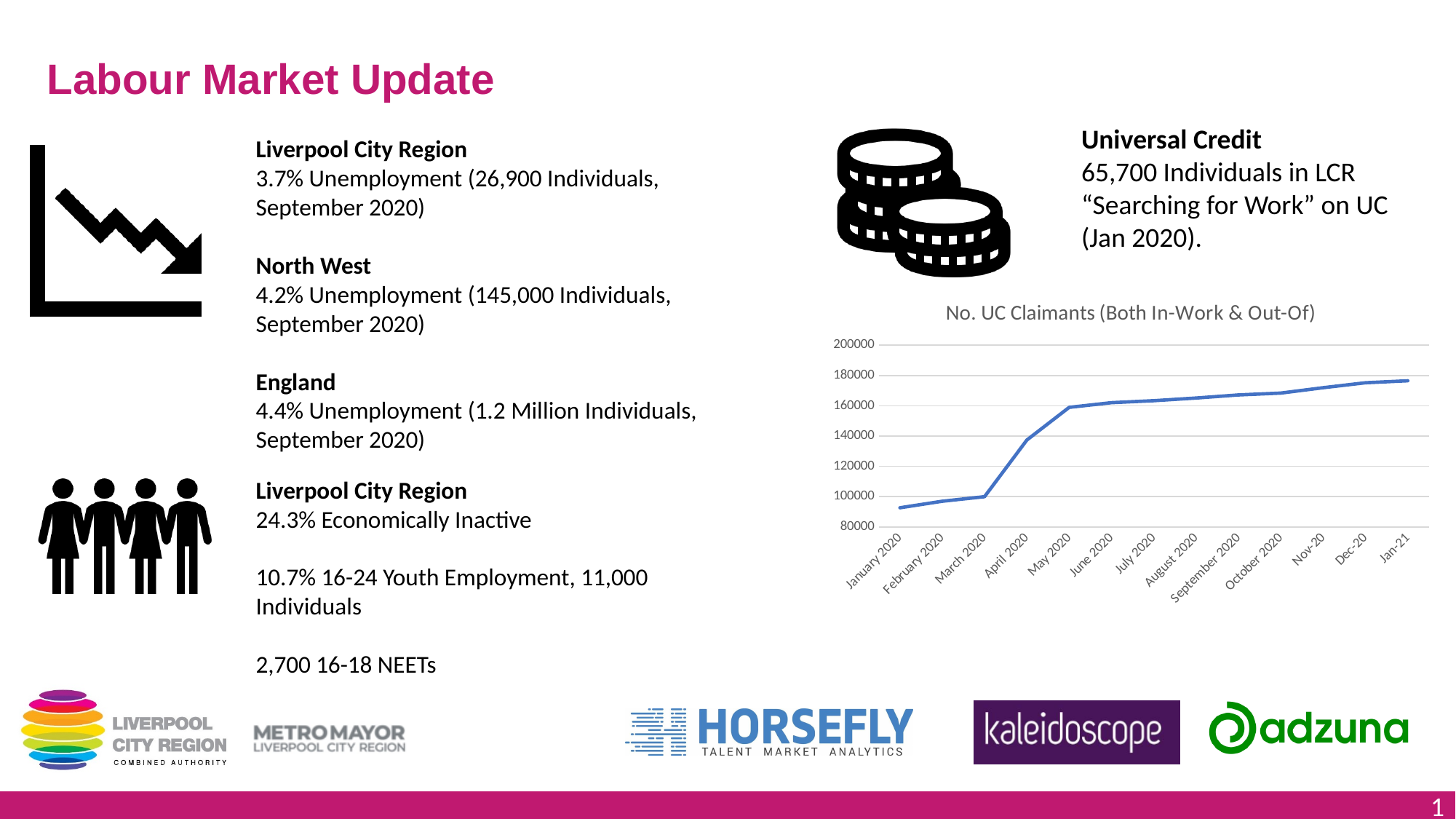
In the UC claimants chart, is the value for May 2020 greater or less than 140000? greater Which month has the highest number of UC claimants in the chart? Jan-21 Which month has the lowest number of UC claimants in the chart? January 2020 In the UC claimants chart, which is larger: the value for March 2020 or the value for May 2020? May 2020 What kind of chart is used to show the number of UC claimants? Line chart In the UC claimants chart, is the value for Jan-21 greater or less than 180000? less What is the lowest value shown on the y axis of the UC claimants chart? 80000 In the UC claimants chart, is the value for January 2020 greater or less than 100000? less How many months are plotted on the x axis of the UC claimants chart? 13 Do the values in the UC claimants chart rise or fall from January 2020 to Jan-21? Rise What is the title of the chart on the right of the slide? No. UC Claimants (Both In-Work & Out-Of)